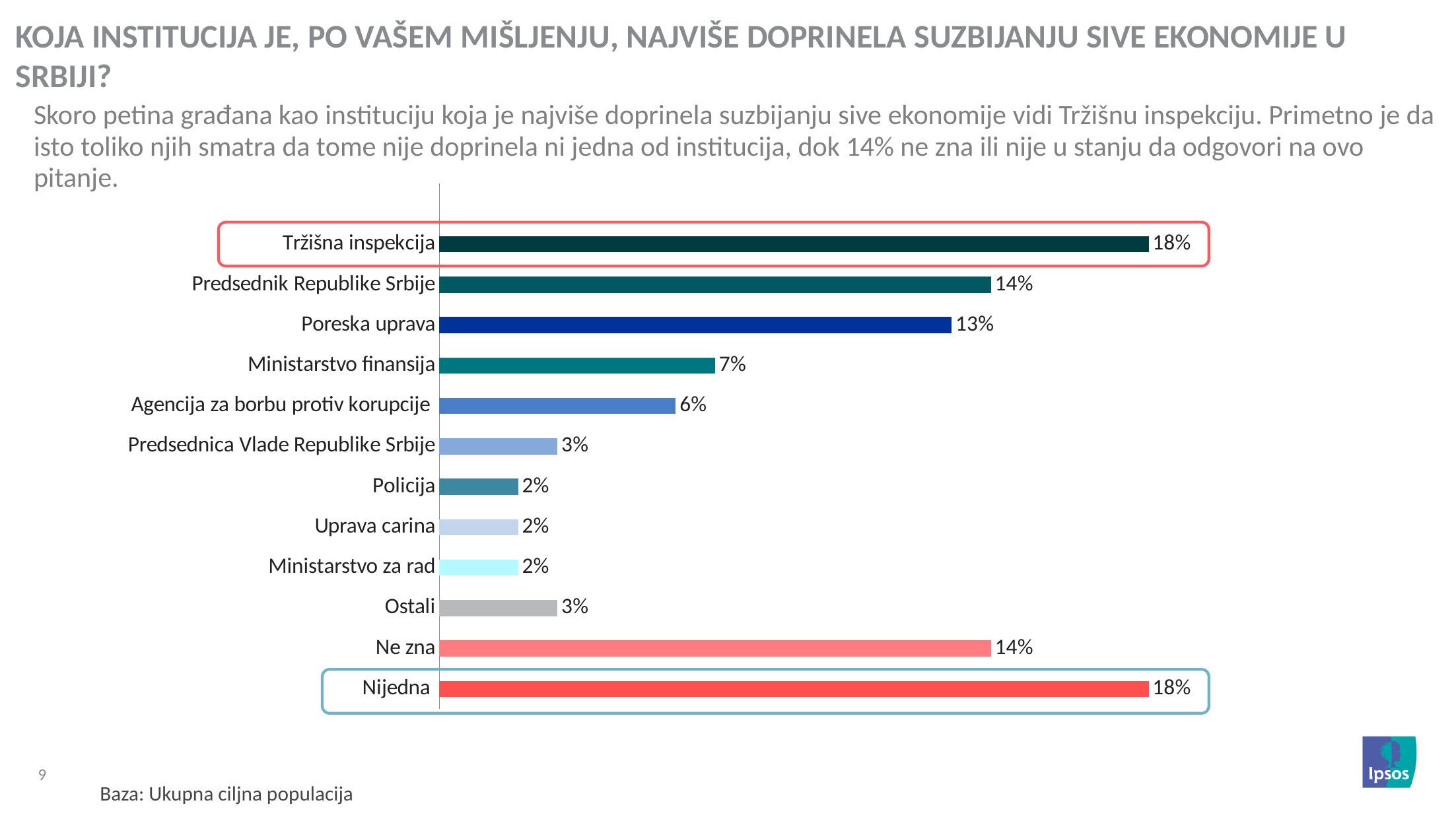
What is the value for Agencija za borbu protiv korupcije? 6% What percentage of respondents answered Ne zna? 14% How many categories are shown in the chart? 12 What is the difference in percentage points between Predsednik Republike Srbije and Predsednica Vlade Republike Srbije? 11 percentage points What is the difference in percentage points between Tržišna inspekcija and Poreska uprava? 5 percentage points What percentage of respondents named Tržišna inspekcija? 18% What type of chart is shown on the slide? Bar chart What is the value shown for Poreska uprava? 13% What percentage is shown for Ministarstvo finansija? 7% Which has a higher value, Poreska uprava or Ministarstvo finansija? Poreska uprava What colour is the bar for Nijedna? Red What is the value shown for Nijedna? 18%